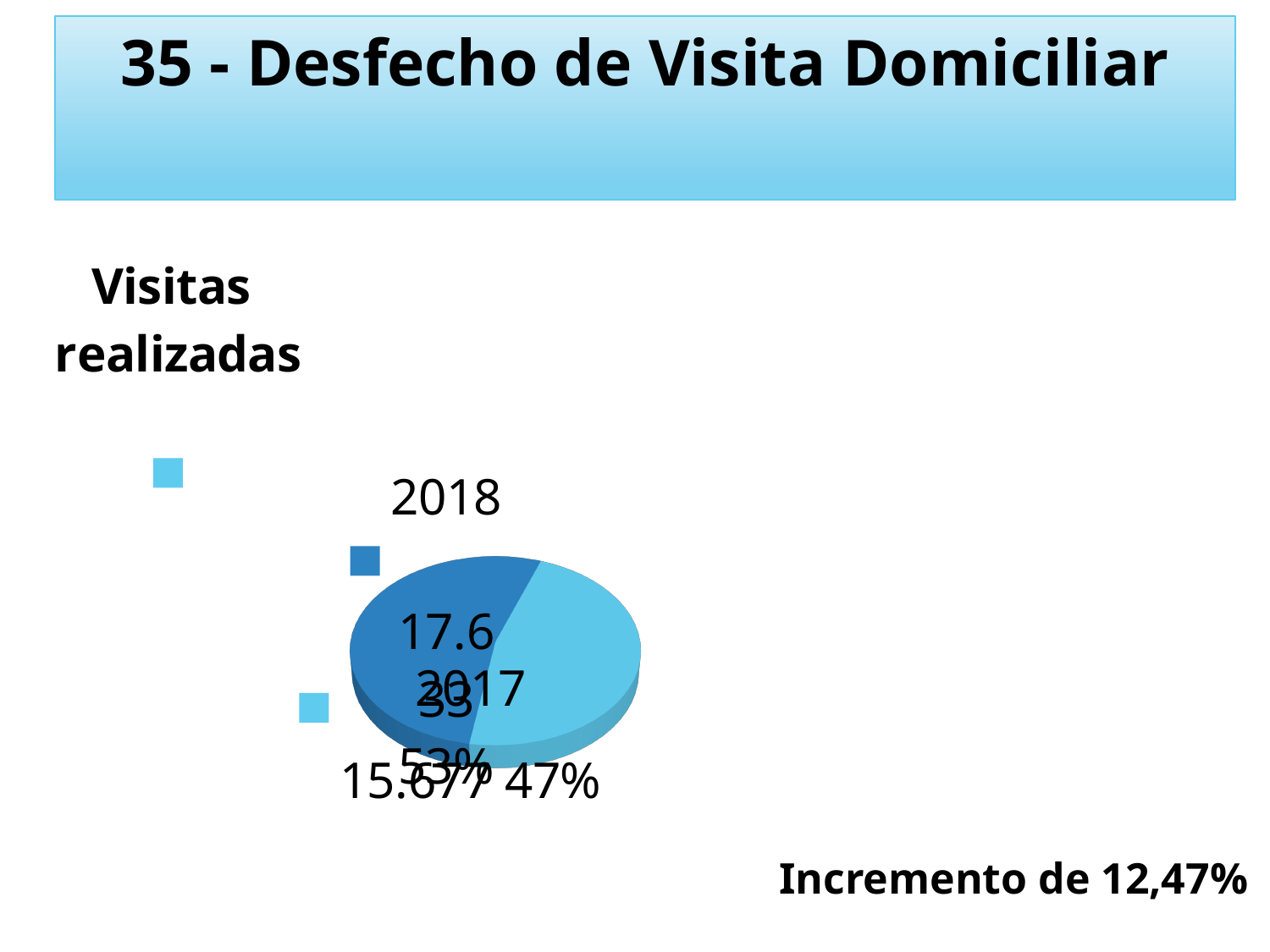
What share of the pie does 2018 represent? 53% What share of the pie does 2017 represent? 47% Which year has the larger slice, 2017 or 2018? 2018 What is the title of the chart? Visitas realizadas How many slices does the pie chart have? 2 What is the value shown for 2017? 15.677 Which year has the largest share of the pie? 2018 Which year has the smallest share of the pie? 2017 What increase is stated in the text below the chart? Incremento de 12,47% What kind of chart is shown on the slide? pie chart